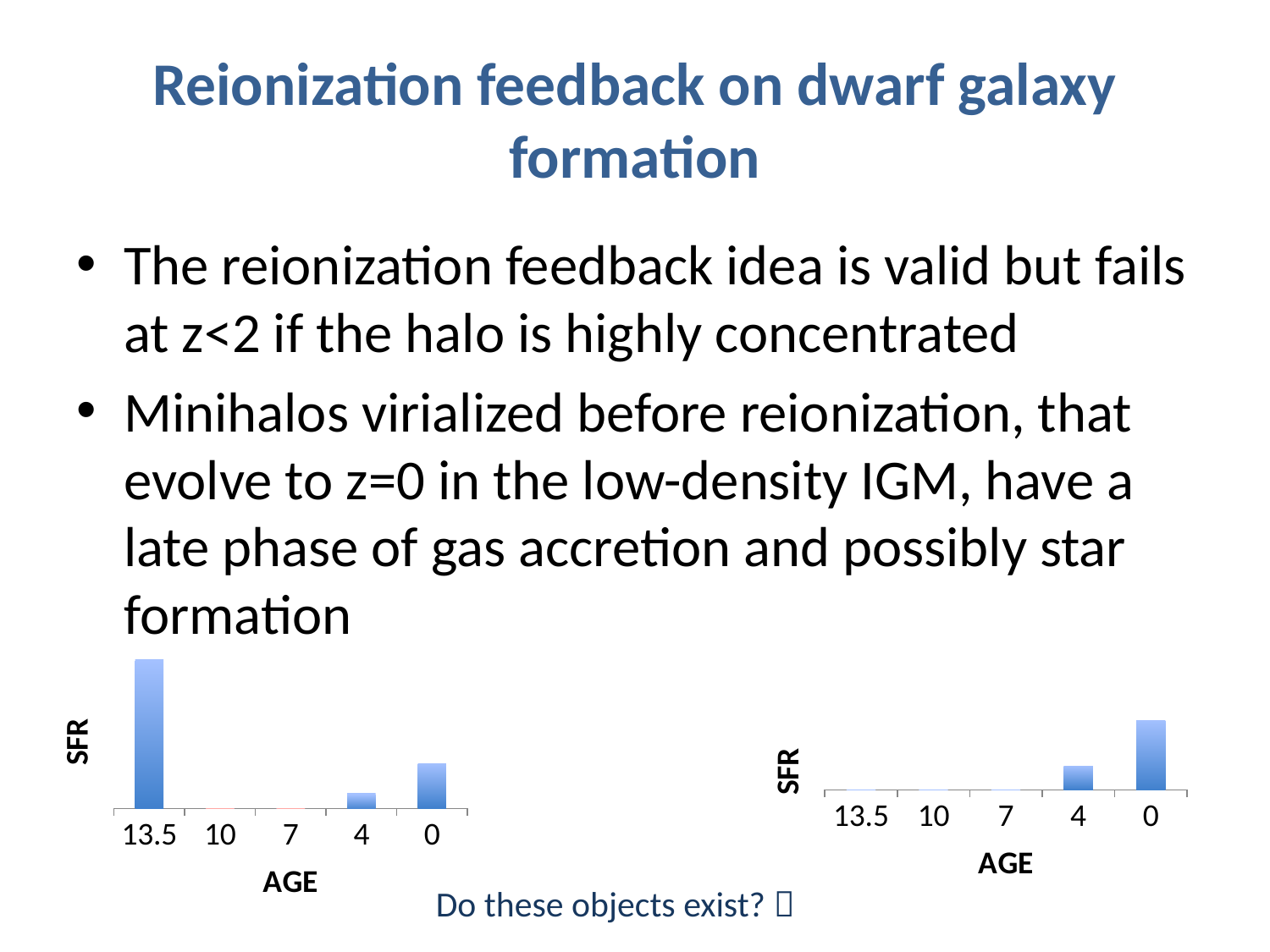
In the left chart, which AGE category has the highest SFR? 13.5 In the right chart, what is the label on the horizontal axis? AGE In the left chart, is the SFR at AGE 0 larger or smaller than at AGE 4? larger In the right chart, what kind of chart is shown? bar chart In the right chart, is the SFR at AGE 4 larger or smaller than at AGE 0? smaller In the left chart, what is the label on the vertical axis? SFR In the left chart, is the SFR at AGE 13.5 larger or smaller than at AGE 0? larger In the right chart, does the SFR rise or fall from AGE 4 to AGE 0? rise In the left chart, what kind of chart is shown? bar chart In the right chart, how many categories are on the AGE axis? 5 In the left chart, how many categories are on the AGE axis? 5 In the right chart, which AGE category has the highest SFR? 0